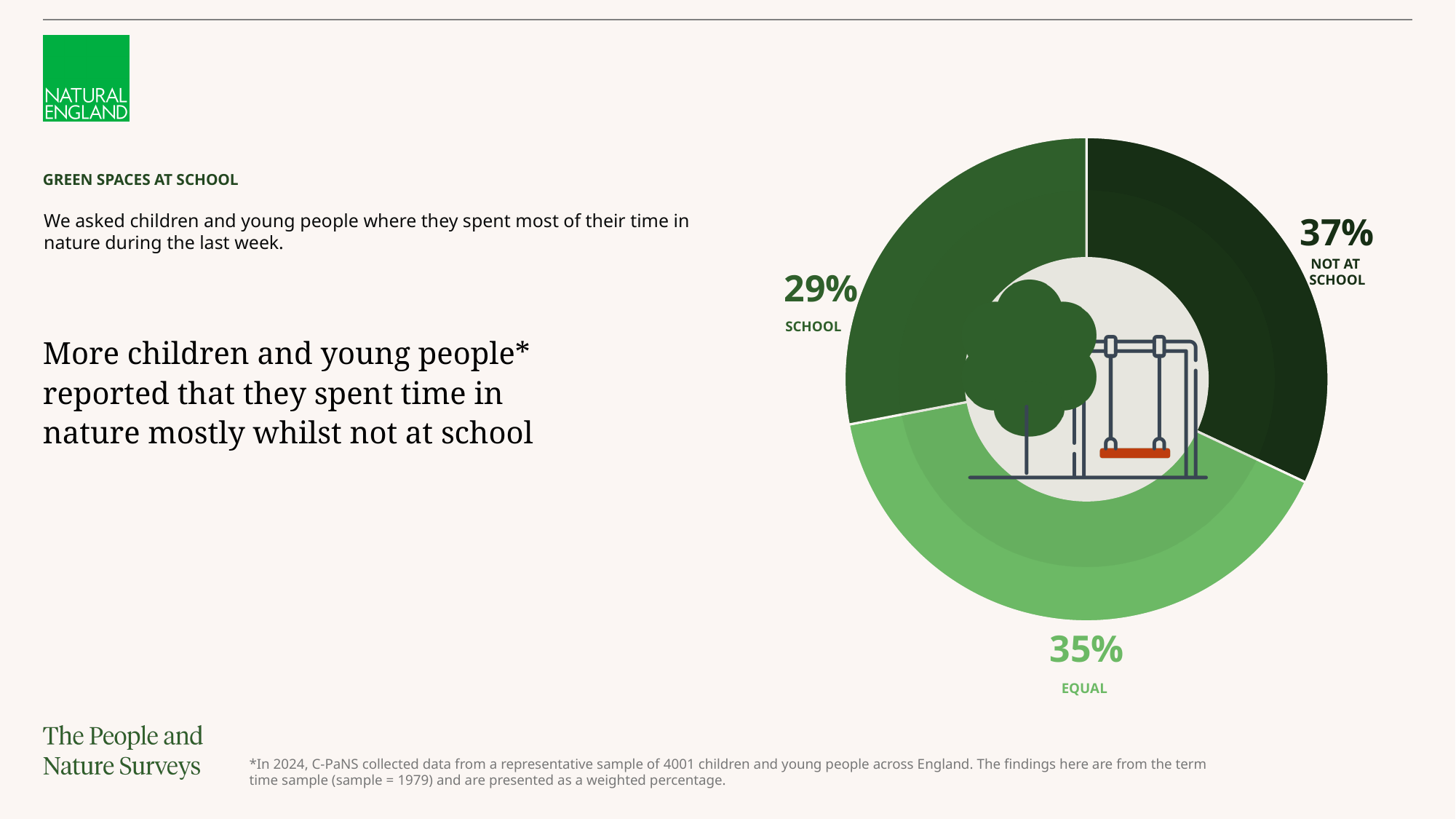
What percentage of children and young people reported spending most of their time in nature while not at school? 37% Which category is shown in the lightest green colour on the pie chart? Equal What is the combined percentage of the 'School' and 'Equal' categories? 64% What percentage of children and young people reported spending most of their time in nature at school? 29% Which category has the smallest share of the pie chart? School Which category has the largest share of the pie chart? Not at school What kind of chart is shown on the slide? Doughnut chart What is the difference in percentage points between the 'Equal' and 'School' categories? 6 What percentage of children and young people reported spending an equal amount of time in nature at school and not at school? 35% Which is larger, the share for 'Equal' or the share for 'School'? Equal What is the difference in percentage points between the 'Not at school' and 'School' categories? 8 How many categories are shown in the pie chart? 3